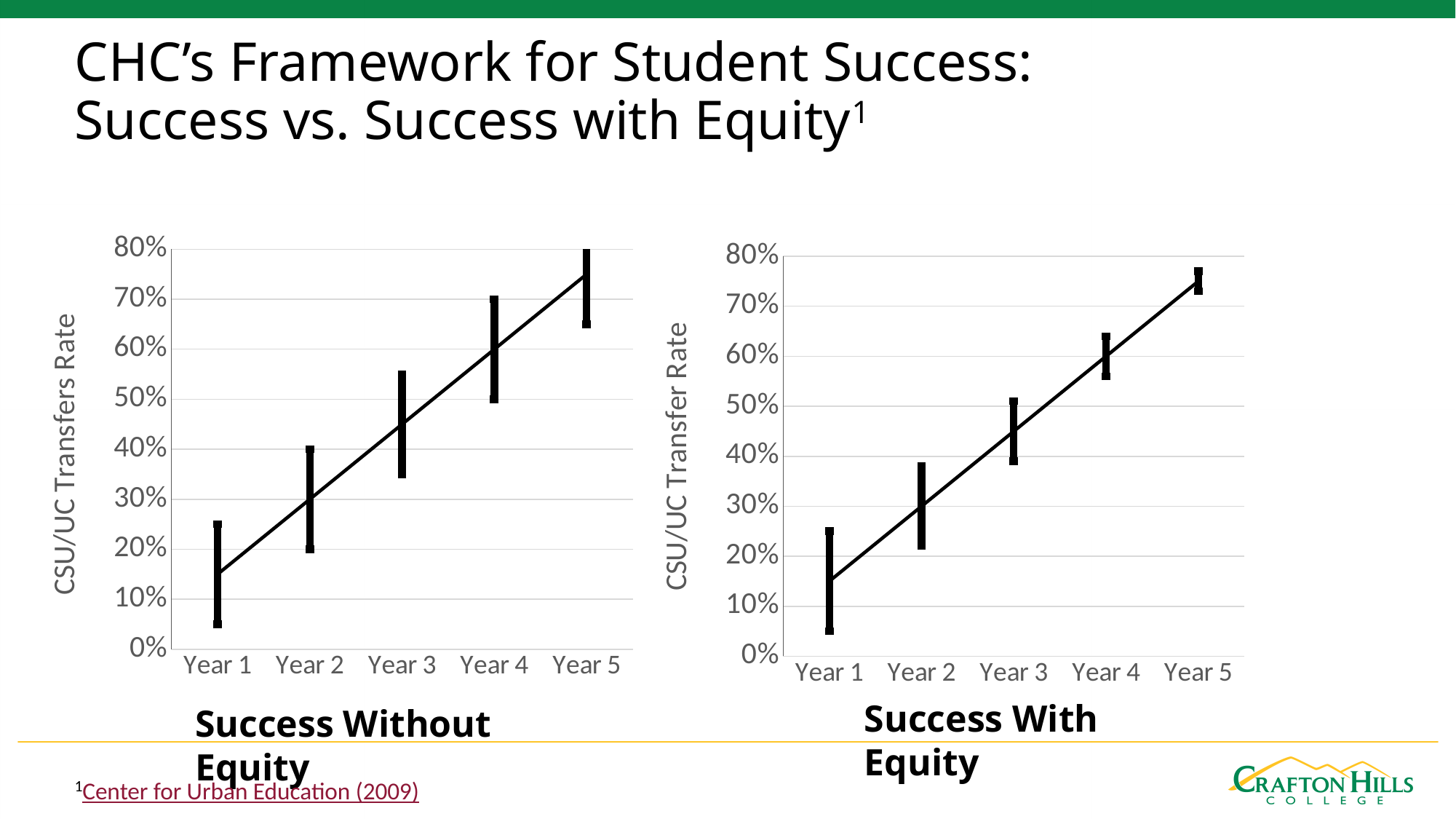
In the 'Success Without Equity' chart, how many years are plotted on the x axis? 5 What is the y-axis label of the 'Success With Equity' chart? CSU/UC Transfer Rate In the 'Success With Equity' chart, is the value for Year 5 greater or less than 70%? greater In the 'Success With Equity' chart, how many categories are shown on the x axis? 5 In the 'Success With Equity' chart, which year has the lowest CSU/UC transfer rate? Year 1 In the 'Success Without Equity' chart, which year has the highest CSU/UC transfer rate? Year 5 In the 'Success Without Equity' chart, do the values rise or fall from Year 1 to Year 5? rise In the 'Success Without Equity' chart, is the value for Year 3 greater or less than 40%? greater In the 'Success With Equity' chart, is the value for Year 1 greater or less than 20%? less In the 'Success Without Equity' chart, what kind of chart is shown? line chart In the 'Success With Equity' chart, do the values rise or fall along the x axis? rise In the 'Success Without Equity' chart, which is larger, the value for Year 2 or the value for Year 4? Year 4